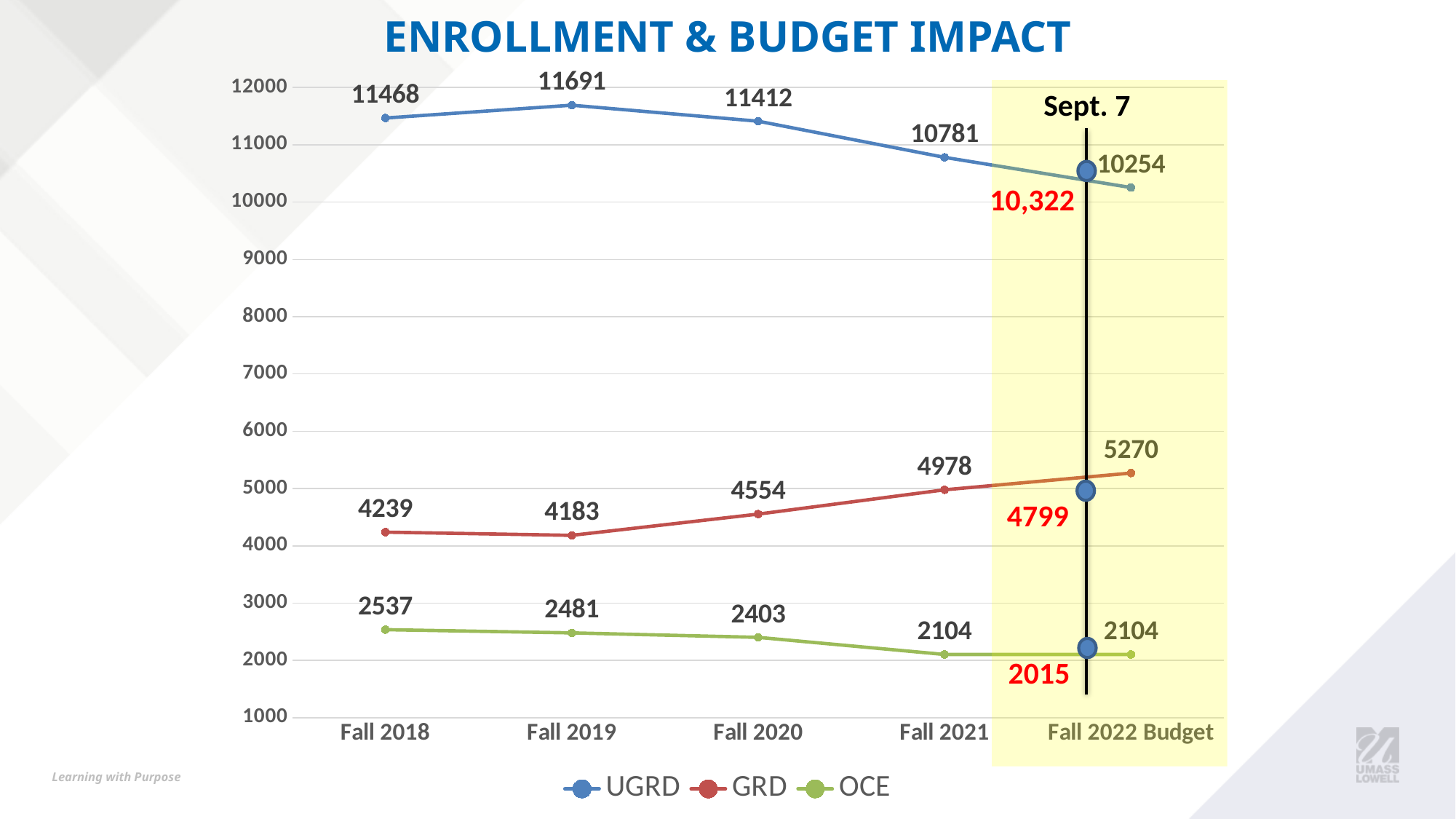
In which period is the UGRD series highest? Fall 2019 What is the GRD value for Fall 2021? 4978 Which is larger, the GRD value for Fall 2020 or the GRD value for Fall 2022 Budget? Fall 2022 Budget What kind of chart is shown? line chart What is the OCE value for Fall 2018? 2537 Does the OCE series rise or fall from Fall 2018 to Fall 2021? fall How many series does the legend list? 3 What is the UGRD value for Fall 2022 Budget? 10254 In which period is the GRD series lowest? Fall 2019 What is the UGRD value for Fall 2019? 11691 How many periods are shown on the x axis? 5 What is the difference between the UGRD values for Fall 2018 and Fall 2021? 687